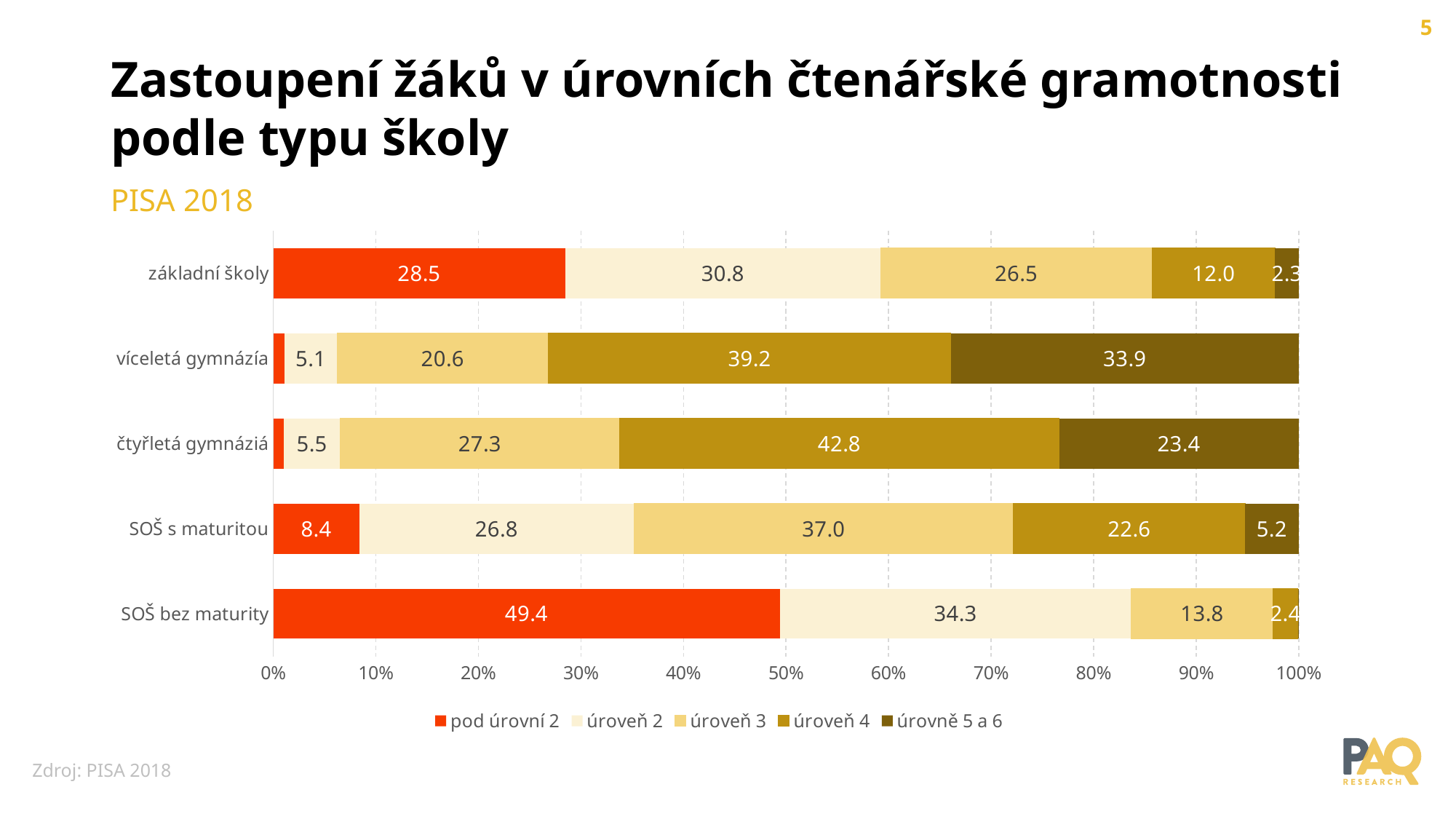
What is the value for 'úrovně 5 a 6' for víceletá gymnázia? 33.9 What is the difference between the 'úroveň 3' values for SOŠ s maturitou and základní školy? 10.5 Which is larger: the 'úroveň 2' value for základní školy or for SOŠ bez maturity? SOŠ bez maturity Is the 'pod úrovní 2' value for víceletá gymnázia greater or less than 10%? less What kind of chart is shown on the slide? stacked bar chart What is the value for 'úroveň 4' for SOŠ s maturitou? 22.6 What is the value for 'pod úrovní 2' for SOŠ bez maturity? 49.4 Which school type has the highest value for 'úroveň 4'? čtyřletá gymnázia Which school type has the lowest value for 'úroveň 2'? víceletá gymnázia How many school types are shown on the chart? 5 Which school type has the highest value for 'pod úrovní 2'? SOŠ bez maturity How many series does the legend list? 5